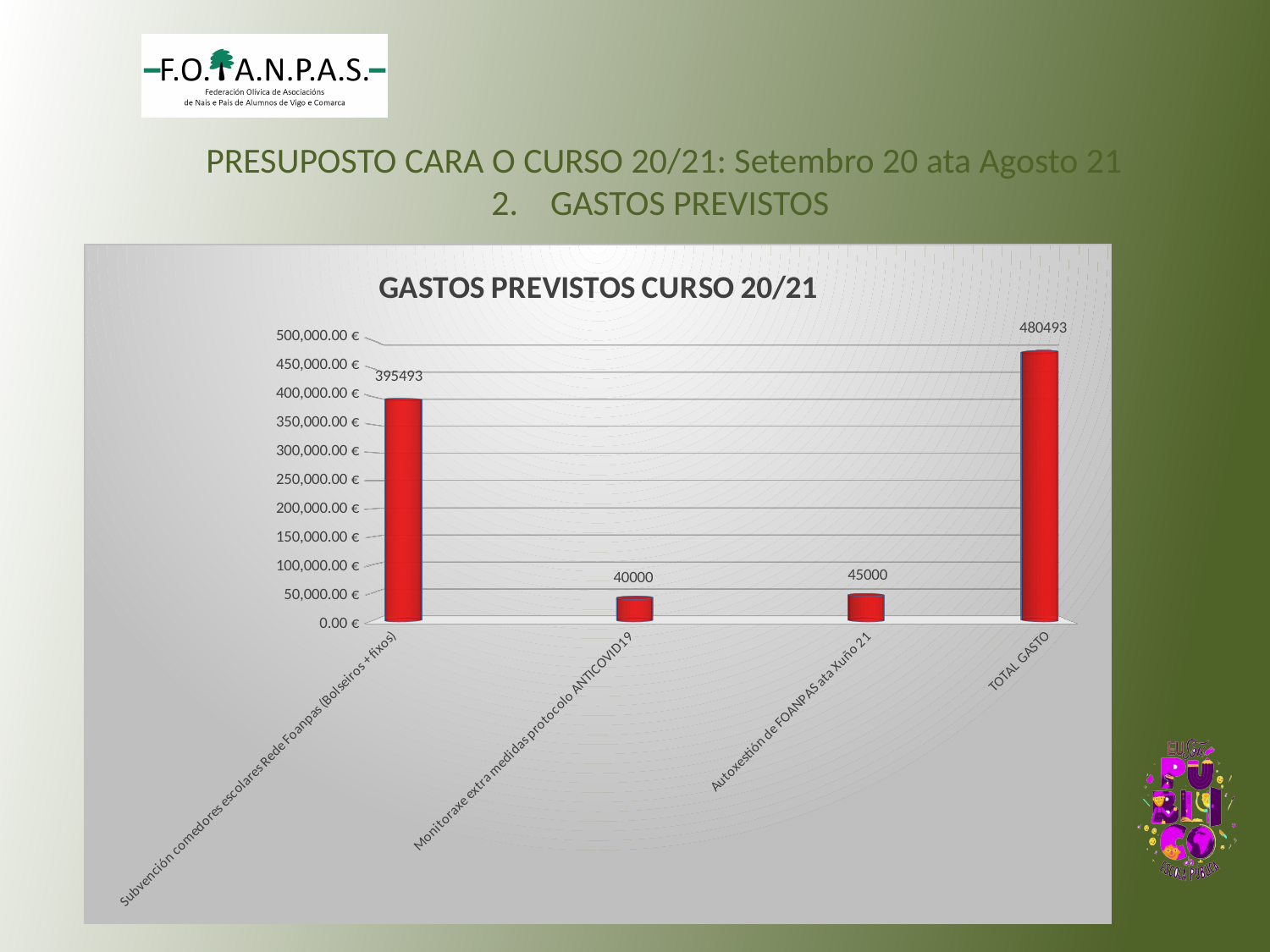
What is the difference between TOTAL GASTO and Subvención comedores escolares Rede Foanpas (Bolseiros + fixos)? 85000 Which is larger, Autoxestión de FOANPAS ata Xuño 21 or Monitoraxe extra medidas protocolo ANTICOVID19? Autoxestión de FOANPAS ata Xuño 21 What is the value for Autoxestión de FOANPAS ata Xuño 21? 45000 Is the value for Subvención comedores escolares Rede Foanpas (Bolseiros + fixos) greater or less than 350,000.00 €? greater Which category has the lowest value? Monitoraxe extra medidas protocolo ANTICOVID19 What is the value for Subvención comedores escolares Rede Foanpas (Bolseiros + fixos)? 395493 What kind of chart is shown on the slide? Bar chart What is the value for TOTAL GASTO? 480493 Which category has the highest value? TOTAL GASTO How many categories are shown in the chart? 4 What is the value for Monitoraxe extra medidas protocolo ANTICOVID19? 40000 What is the difference between Autoxestión de FOANPAS ata Xuño 21 and Monitoraxe extra medidas protocolo ANTICOVID19? 5000